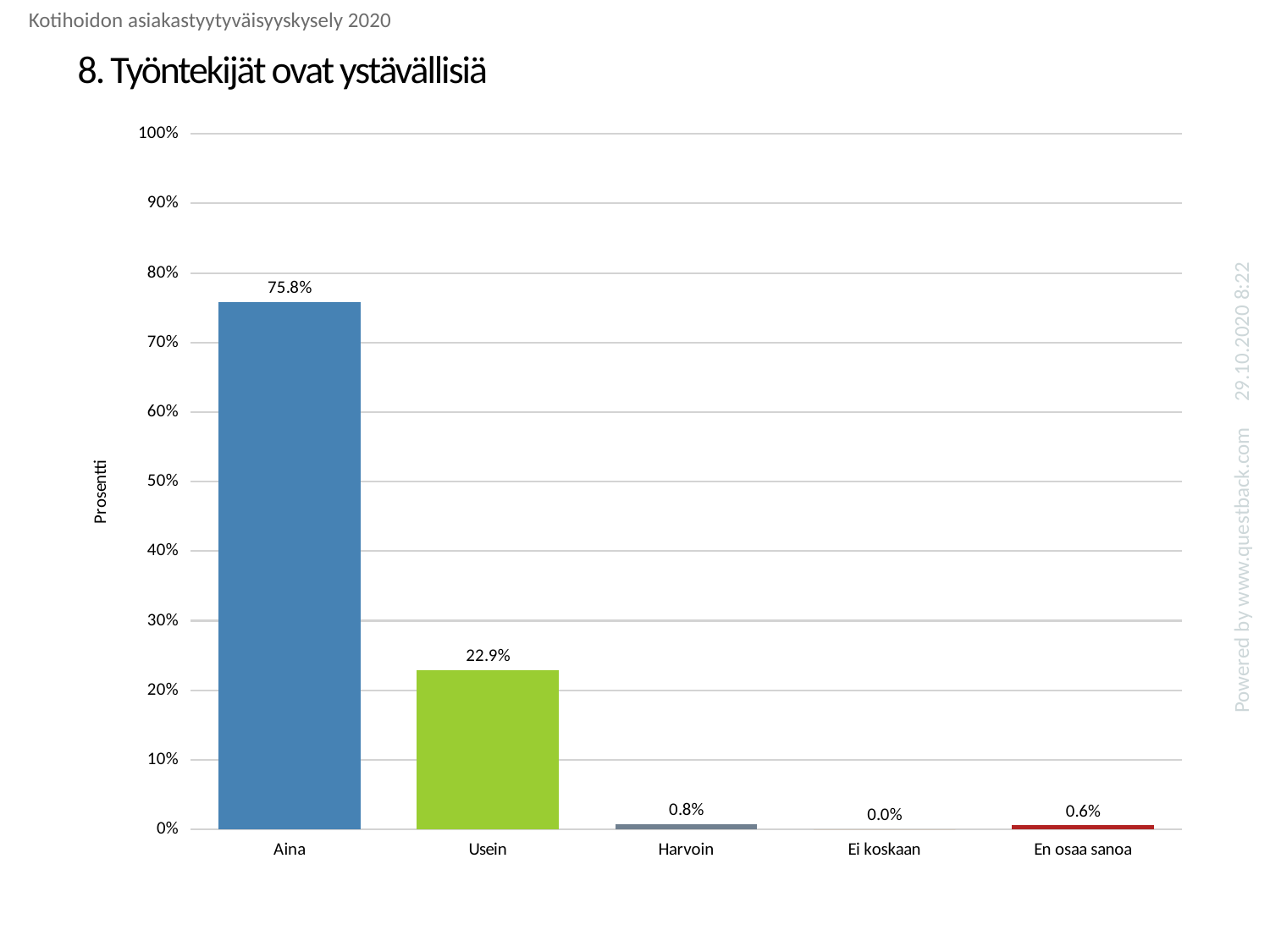
What is the value for Usein? 22.9% What is the value for Harvoin? 0.8% What is the value for En osaa sanoa? 0.6% What is the difference between the values for Aina and Usein? 52.9% What is the title of the chart? 8. Työntekijät ovat ystävällisiä Which is larger, the value for Usein or the value for Harvoin? Usein Which category has the highest value? Aina What is the value for Aina? 75.8% Which category has the lowest value? Ei koskaan Is the value for Aina greater or less than 70%? greater How many categories are shown on the x axis? 5 What kind of chart is shown on the slide? bar chart